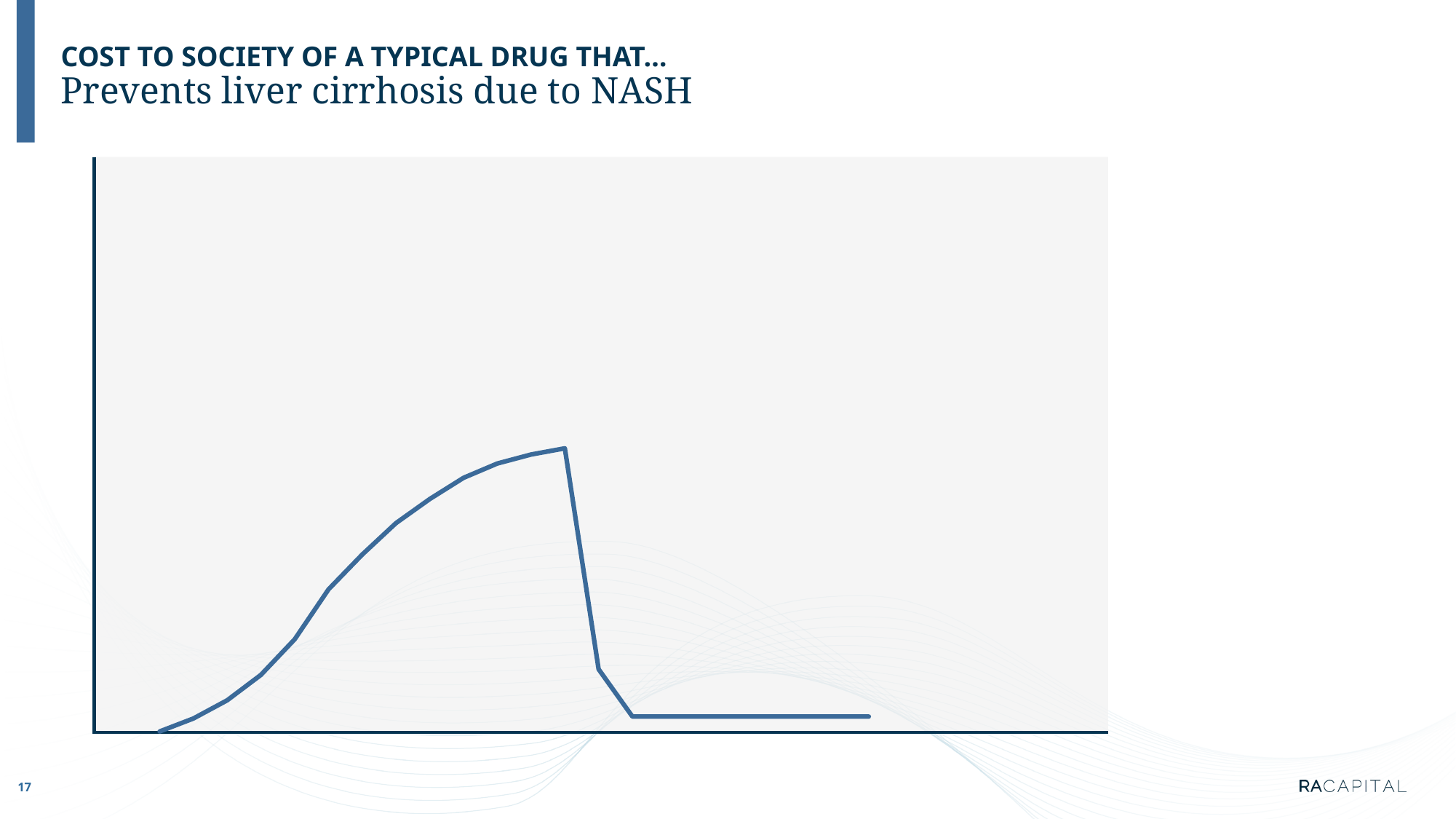
What kind of chart is shown on the slide? line chart What is the subtitle of the chart on the slide? Prevents liver cirrhosis due to NASH Is the right-hand portion of the line flat, rising, or falling? flat Does the plotted line rise or fall along the x axis before its peak? rise How many lines are plotted on the chart? 1 What is the heading above the chart's subtitle? COST TO SOCIETY OF A TYPICAL DRUG THAT... Does the line rise or fall sharply immediately after its peak? fall